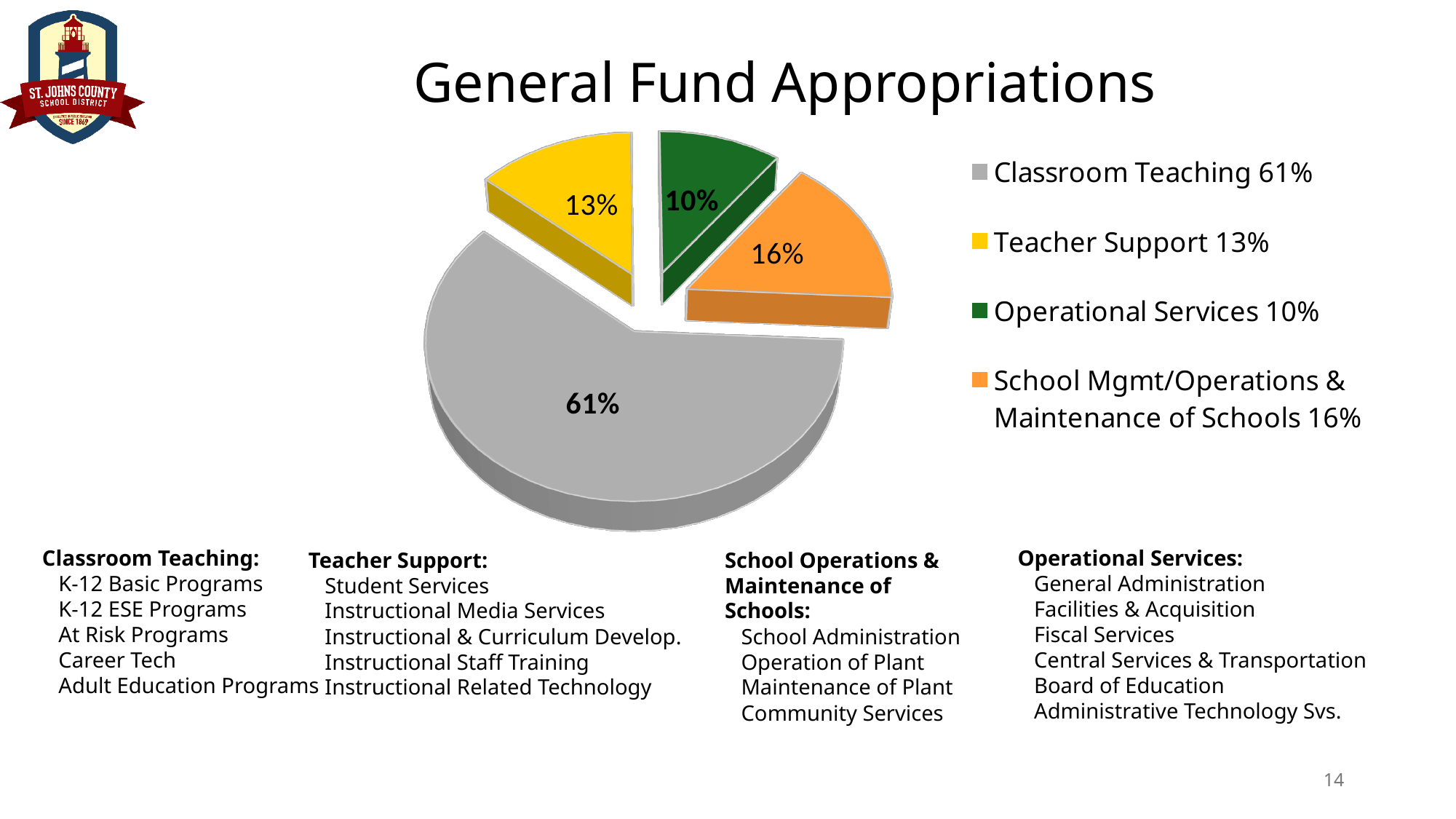
How many slices does the pie chart have? 4 What is the title of the chart? General Fund Appropriations Which category has the smallest slice of the pie? Operational Services What is the difference in percentage points between Classroom Teaching and School Mgmt/Operations & Maintenance of Schools? 45 What share of General Fund Appropriations goes to Classroom Teaching? 61% What share does School Mgmt/Operations & Maintenance of Schools receive? 16% What type of chart is shown on the slide? Pie chart What percentage is shown for Operational Services? 10% Which is larger, Teacher Support or Operational Services? Teacher Support Which category has the largest slice of the pie? Classroom Teaching What percentage of the pie is Teacher Support? 13% What colour is the Operational Services slice? Green